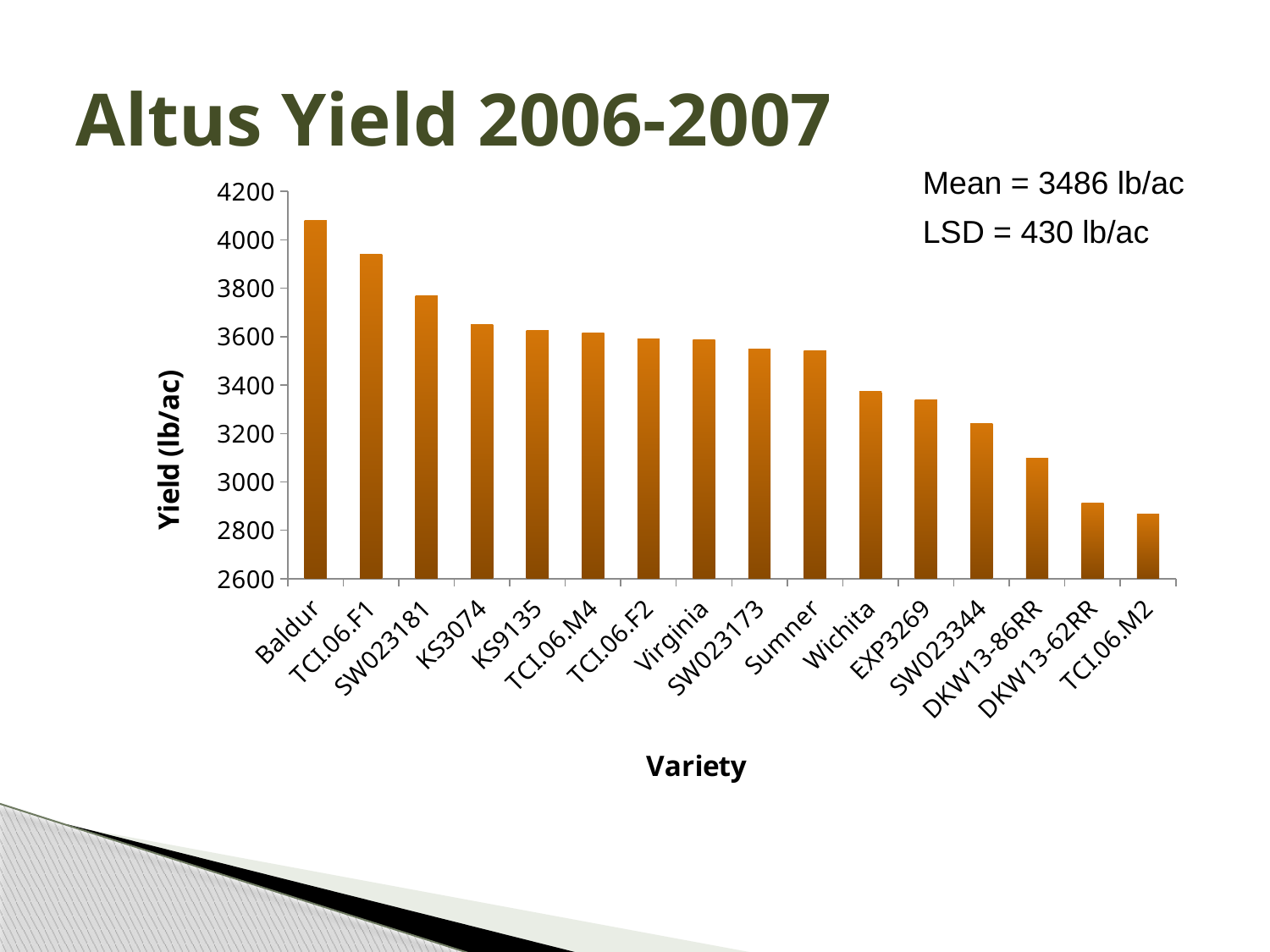
What kind of chart is shown on the slide? bar chart What is the label of the y axis? Yield (lb/ac) Do the yields rise or fall from left to right across the varieties? fall Which variety has the lowest yield? TCI.06.M2 Is the value for Wichita greater or less than 3400? less Is the value for SW023181 greater or less than 3600? greater Is the value for DKW13-62RR greater or less than 3000? less Which has a higher yield, TCI.06.F1 or SW023344? TCI.06.F1 How many varieties are shown on the chart? 16 Which variety has the highest yield? Baldur Which has a lower yield, Sumner or DKW13-86RR? DKW13-86RR